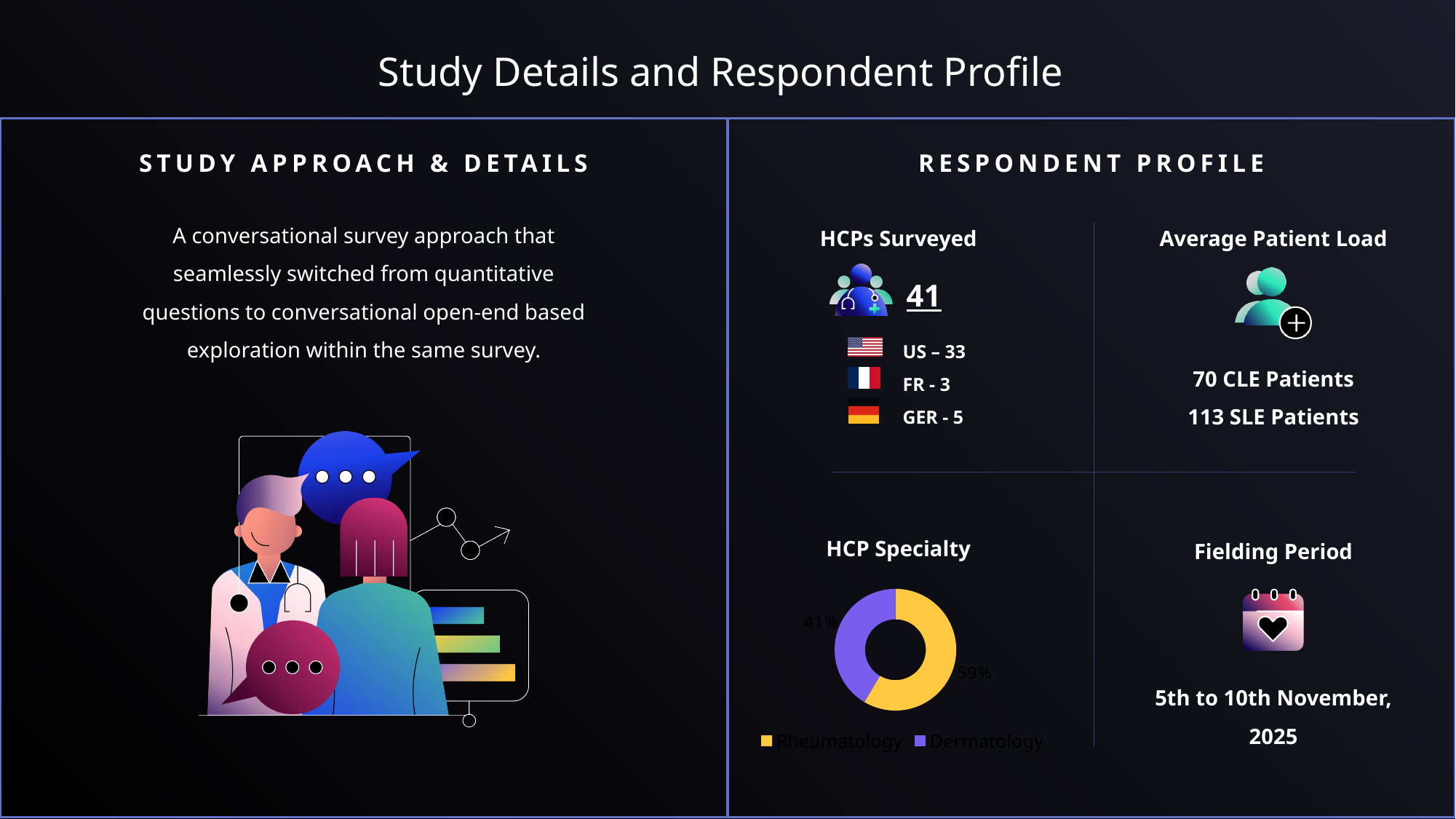
In the HCP Specialty chart, is the Rheumatology share greater or less than 50%? greater In the HCP Specialty chart, which specialty has the smaller share? Dermatology In the HCP Specialty chart, what is the difference in percentage points between Rheumatology and Dermatology? 18 In the HCP Specialty chart, which specialty has the larger share? Rheumatology In the HCP Specialty chart, which colour represents Dermatology? Purple In the HCP Specialty chart, is the Dermatology share larger or smaller than the Rheumatology share? Smaller In the HCP Specialty chart, what share of respondents are Dermatology? 41% What type of chart is shown under HCP Specialty? Donut (pie) chart How many categories does the HCP Specialty chart show? 2 In the HCP Specialty chart, what share of respondents are Rheumatology? 59% How many entries does the legend of the HCP Specialty chart list? 2 In the HCP Specialty chart, which colour represents Rheumatology? Yellow